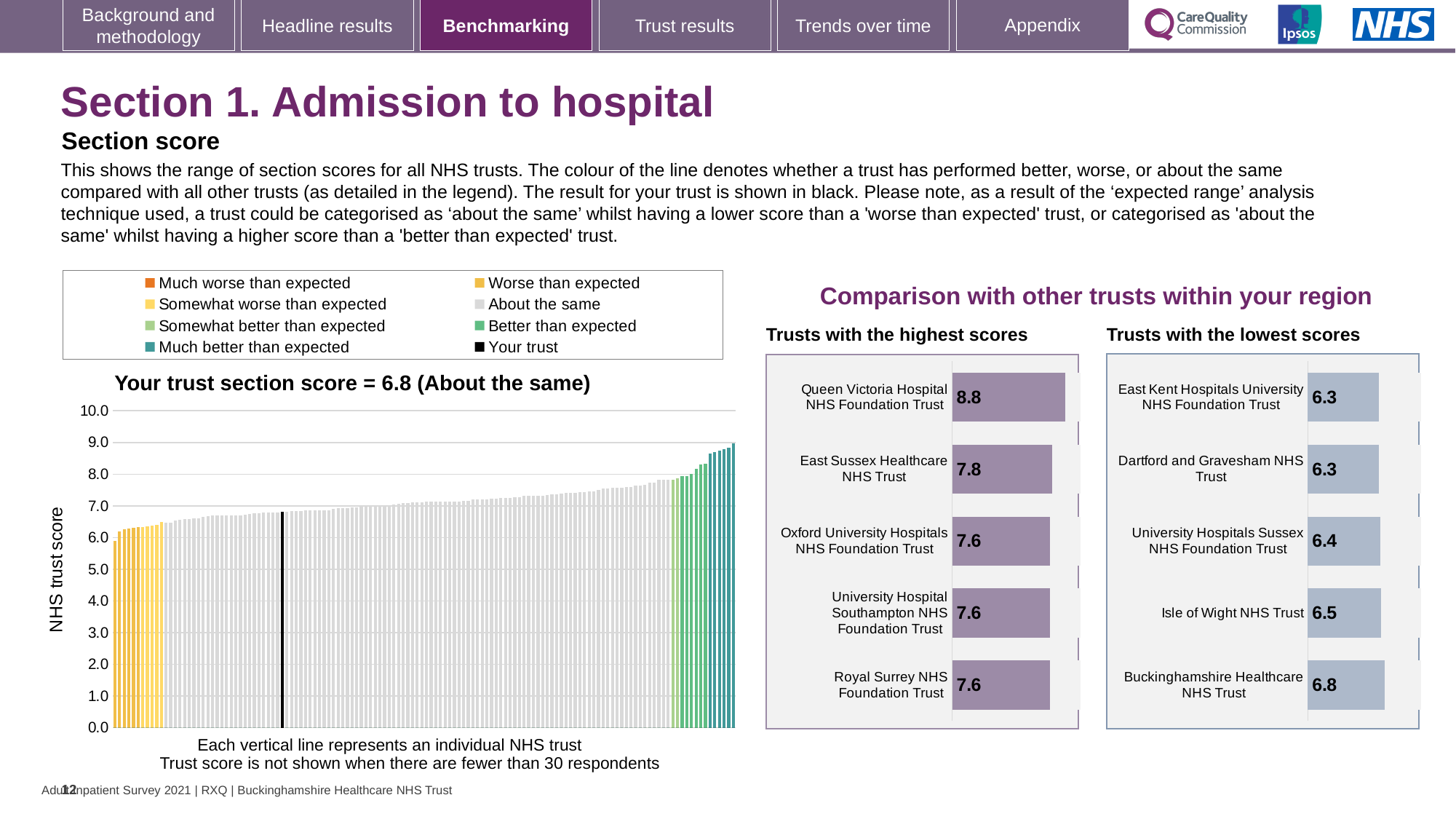
In the 'Trusts with the lowest scores' chart, what is the difference between the scores of Buckinghamshire Healthcare NHS Trust and East Kent Hospitals University NHS Foundation Trust? 0.5 In the 'Trusts with the lowest scores' chart, what is the score for Isle of Wight NHS Trust? 6.5 In the 'Trusts with the highest scores' chart, what is the score for East Sussex Healthcare NHS Trust? 7.8 In the 'Trusts with the highest scores' chart, which trust has the highest score? Queen Victoria Hospital NHS Foundation Trust In the 'Trusts with the lowest scores' chart, which has the larger score: Isle of Wight NHS Trust or University Hospitals Sussex NHS Foundation Trust? Isle of Wight NHS Trust In the 'Trusts with the highest scores' chart, what is the score for Queen Victoria Hospital NHS Foundation Trust? 8.8 In the 'Your trust section score' chart, do the bar values rise or fall from left to right along the x axis? rise In the 'Trusts with the lowest scores' chart, which trust has the highest score? Buckinghamshire Healthcare NHS Trust How many trusts are shown in the 'Trusts with the highest scores' chart? 5 How many entries does the legend above the 'Your trust section score' chart list? 8 In the 'Trusts with the highest scores' chart, what is the difference between the scores of Queen Victoria Hospital NHS Foundation Trust and East Sussex Healthcare NHS Trust? 1.0 In the 'Your trust section score' chart, what is the section score for your trust? 6.8